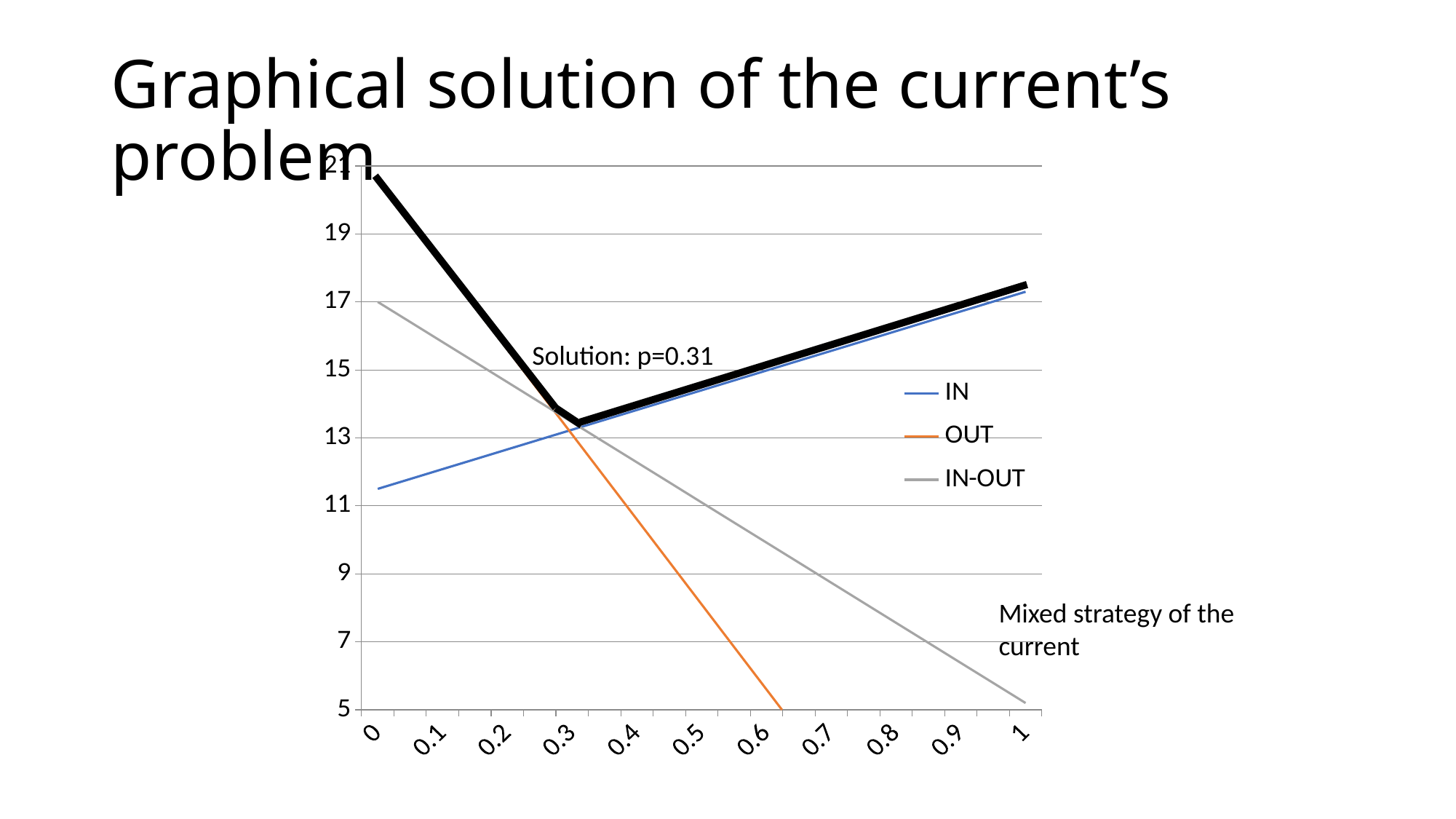
What kind of chart is shown on the slide? line chart How many tick labels are shown on the x axis? 11 Does the IN series rise or fall as the mixed strategy goes from 0 to 1? rise Does the IN-OUT series rise or fall as the mixed strategy goes from 0 to 1? fall Is the value of the IN-OUT series at 1 greater or less than 7? less What are the three series named in the legend? IN, OUT, IN-OUT Is the value of the IN series at 1 greater or less than 15? greater Is the value of the OUT series at 0.5 greater or less than 11? less At a mixed strategy of 0.8, which series has the larger value, IN or IN-OUT? IN How many series does the legend list? 3 What solution value of p is annotated on the chart? p=0.31